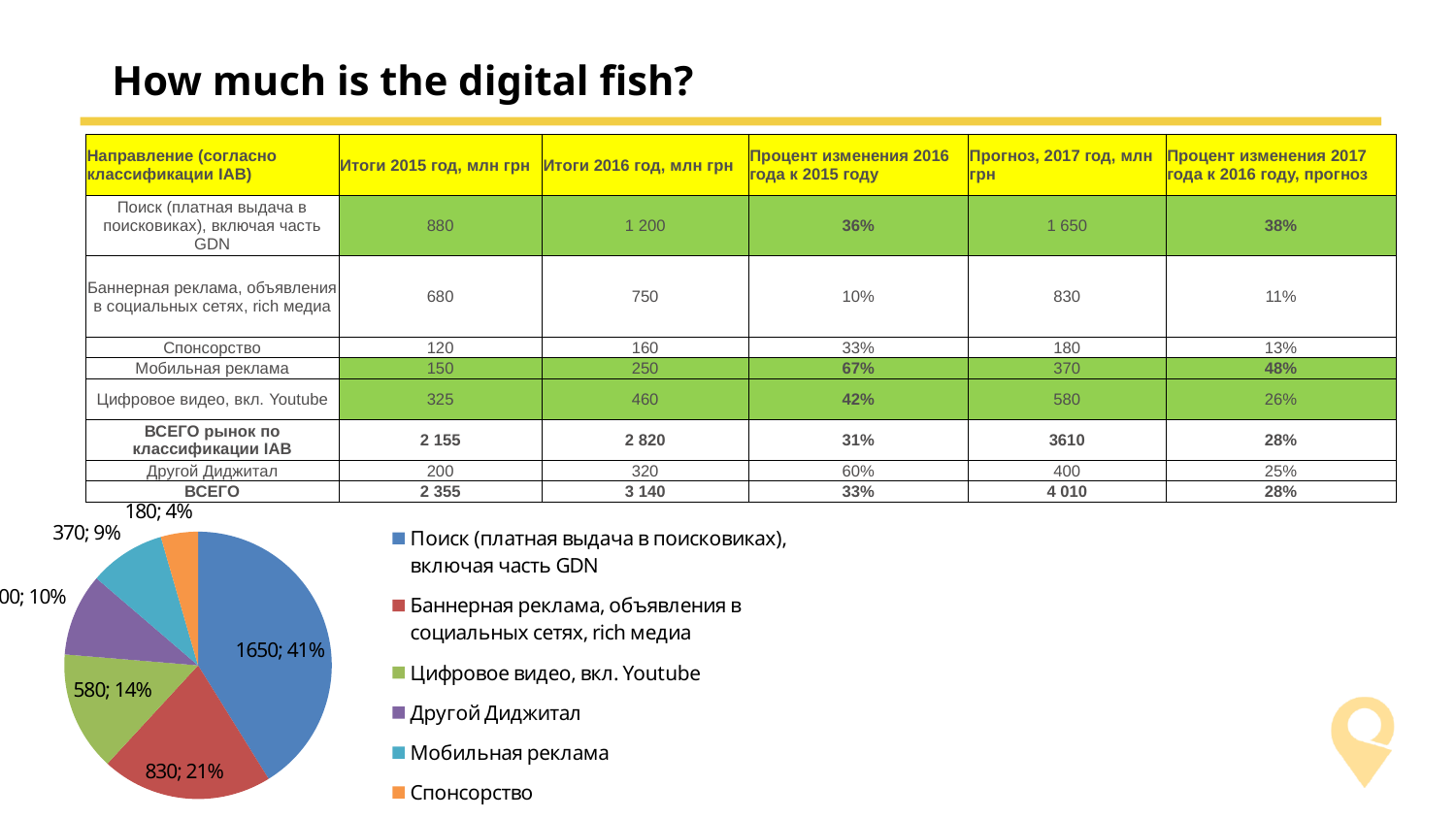
Which slice of the pie chart is the smallest? Спонсорство In the pie chart, what share does Спонсорство have? 4% What kind of chart is shown on the slide? pie chart In the pie chart, what share does Мобильная реклама have? 9% How many entries does the pie chart's legend list? 6 In the pie chart, what value is shown for Баннерная реклама, объявления в социальных сетях, rich медиа? 830 Which slice of the pie chart is the largest? Поиск (платная выдача в поисковиках), включая часть GDN In the pie chart, what share does Поиск (платная выдача в поисковиках), включая часть GDN have? 41% How many slices does the pie chart have? 6 In the pie chart, what is the difference between the values for Баннерная реклама, объявления в социальных сетях, rich медиа and Цифровое видео, вкл. Youtube? 250 In the pie chart, what value is shown for Поиск (платная выдача в поисковиках), включая часть GDN? 1650